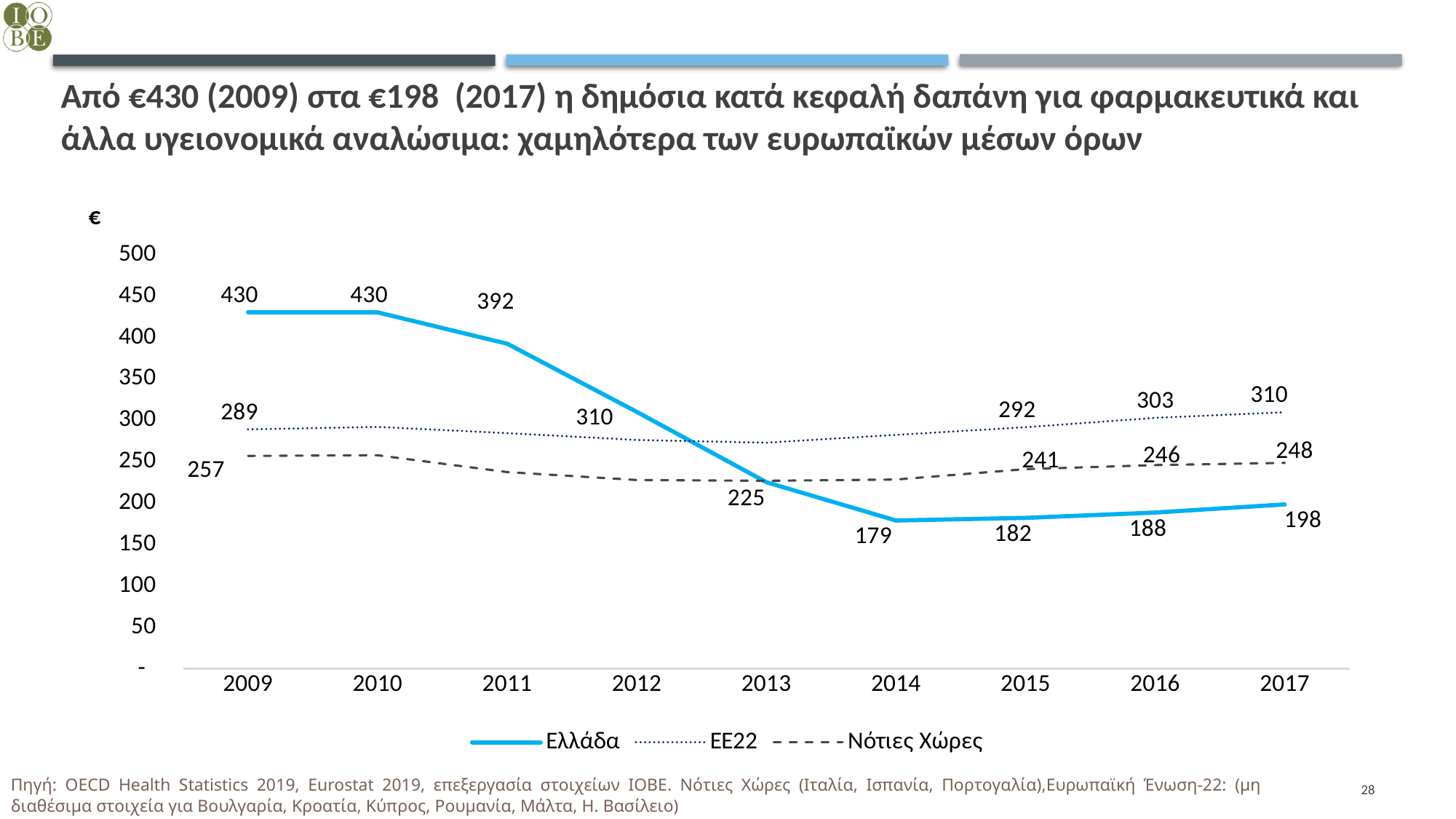
What is the difference between the Ελλάδα values in 2009 and 2017? 232 What is the value for Ελλάδα in 2014? 179 In which year is the value for Ελλάδα lowest? 2014 What is the value for Ελλάδα in 2017? 198 Does the value for Ελλάδα rise or fall from 2009 to 2014? fall What type of chart is shown on the slide? line chart How many series does the legend list? 3 How many years are shown on the x axis? 9 In 2017, which is larger: the value for Ελλάδα or the value for Νότιες Χώρες? Νότιες Χώρες What is the difference between the ΕΕ22 value and the Ελλάδα value in 2017? 112 What is the value for ΕΕ22 in 2016? 303 What is the value for Νότιες Χώρες in 2015? 241